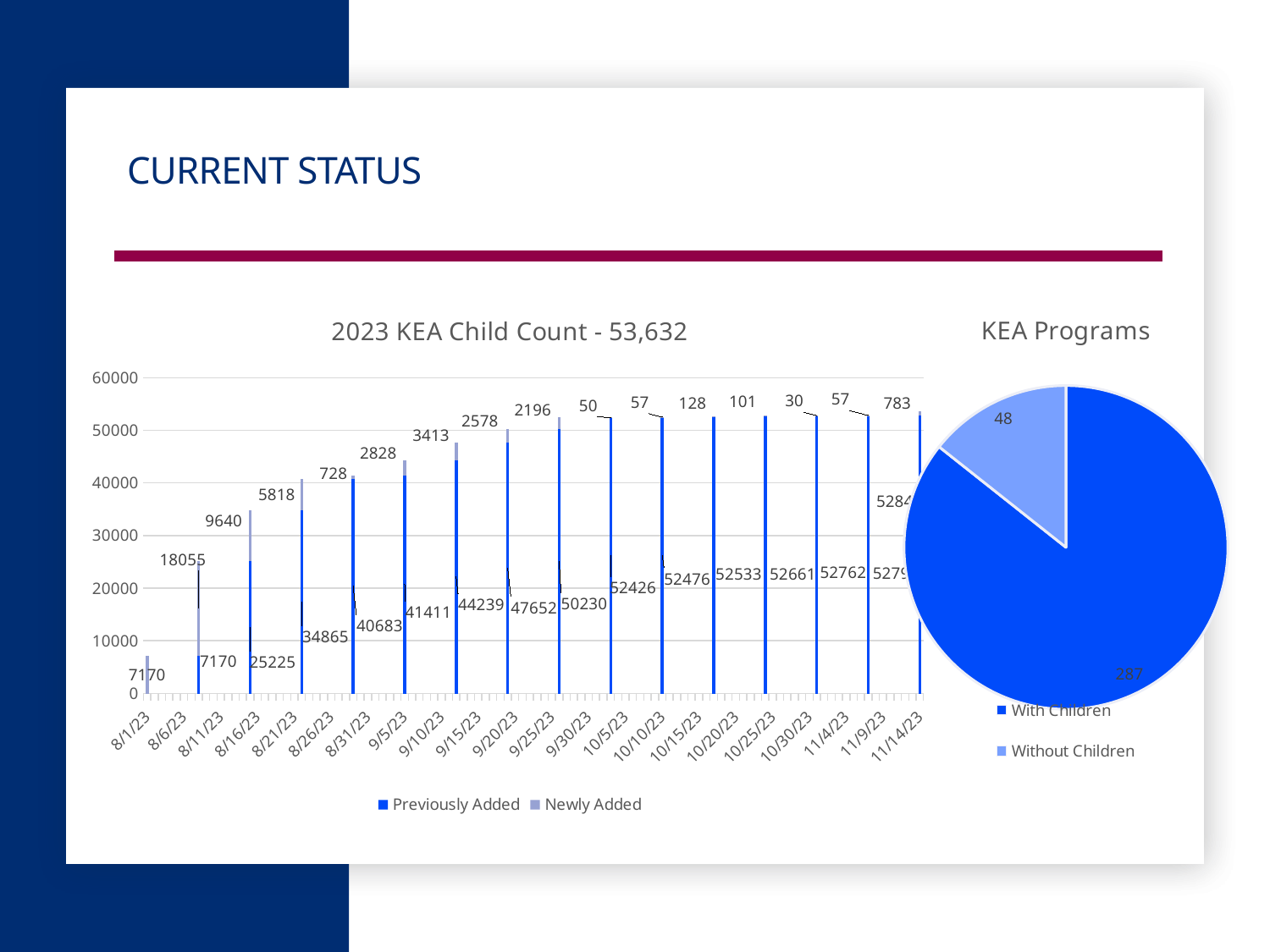
In the '2023 KEA Child Count - 53,632' chart, do the 'Previously Added' values rise or fall from left to right along the x axis? rise In the '2023 KEA Child Count - 53,632' chart, what is the largest 'Newly Added' value labeled on any bar? 18055 In the 'KEA Programs' pie chart, what is the value for 'With Children'? 287 What is the title of the chart on the left of the slide? 2023 KEA Child Count - 53,632 In the 'KEA Programs' pie chart, which slice is larger, 'With Children' or 'Without Children'? With Children What kind of chart is the '2023 KEA Child Count - 53,632' chart? bar chart In the '2023 KEA Child Count - 53,632' chart, what is the total of the bar whose 'Previously Added' value is 25225 and 'Newly Added' value is 9640? 34865 In the '2023 KEA Child Count - 53,632' chart, what is the smallest 'Newly Added' value labeled on any bar? 30 What kind of chart is the 'KEA Programs' chart? pie chart In the 'KEA Programs' pie chart, what is the value for 'Without Children'? 48 How many series does the legend of the '2023 KEA Child Count - 53,632' chart list? 2 In the 'KEA Programs' pie chart, what is the difference between the 'With Children' and 'Without Children' values? 239